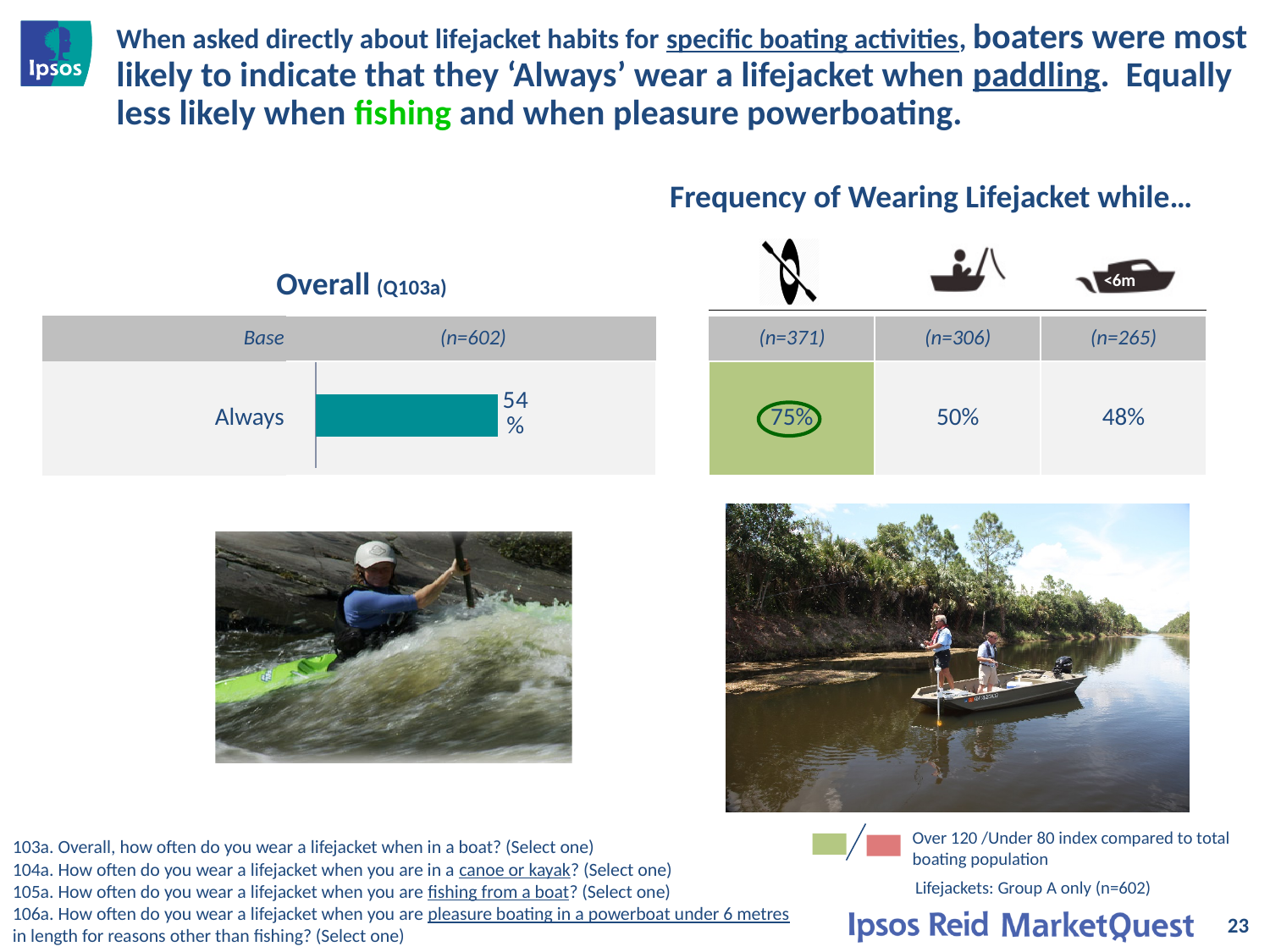
In the 'Frequency of Wearing Lifejacket while…' table, what percentage 'Always' wear a lifejacket when pleasure boating in a powerboat under 6 metres? 48% In the 'Frequency of Wearing Lifejacket while…' table, what is the difference between the canoe/kayak percentage and the powerboat under 6 metres percentage? 27 percentage points Is the 'Always' value in the Overall (Q103a) bar chart greater or less than 50%? greater Is the 'Always' percentage for canoe or kayak higher or lower than the Overall 'Always' percentage in the bar chart? higher What kind of chart is the Overall (Q103a) chart? bar chart In the 'Frequency of Wearing Lifejacket while…' table, which activity has the highest 'Always' percentage? canoe or kayak (paddling) In the 'Frequency of Wearing Lifejacket while…' table, what percentage 'Always' wear a lifejacket when fishing from a boat? 50% What is the base size shown for the Overall (Q103a) bar chart? n=602 What is the title of the bar chart on the left of the slide? Overall (Q103a) In the Overall (Q103a) bar chart, what percentage of boaters say they 'Always' wear a lifejacket? 54% In the 'Frequency of Wearing Lifejacket while…' table, what percentage 'Always' wear a lifejacket when in a canoe or kayak? 75% How many categories are plotted in the Overall (Q103a) bar chart? 1